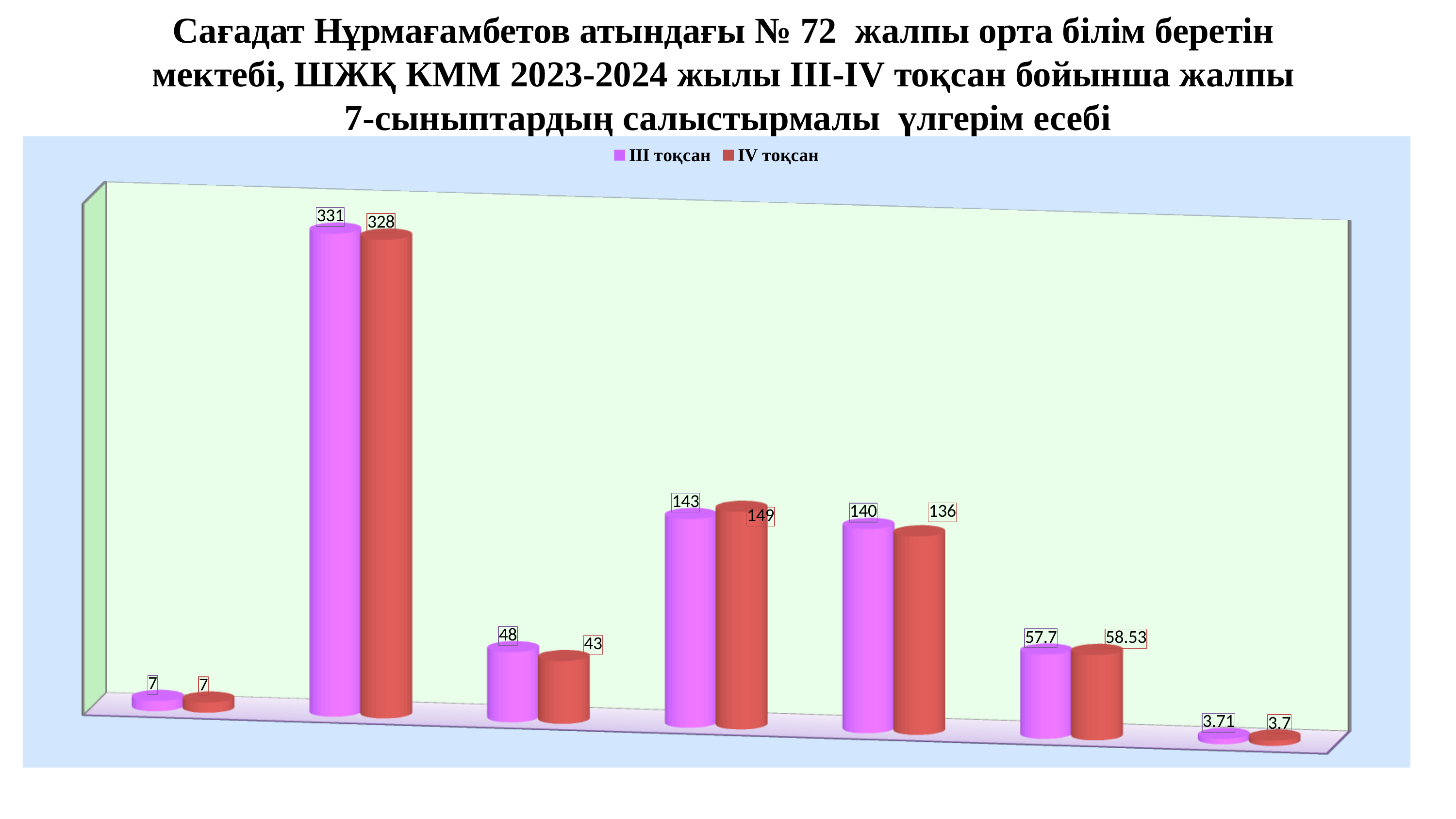
In the fifth group of bars from the left, which is larger: the III тоқсан value or the IV тоқсан value? III тоқсан (140) What is the III тоқсан value for the second group of bars from the left? 331 Which group of bars has the highest III тоқсан value? the second group from the left (331) Which series is shown in red in the legend? IV тоқсан How many groups of bars are plotted along the x axis? 7 What is the IV тоқсан value for the fourth group of bars from the left? 149 What is the difference between the III тоқсан and IV тоқсан values in the third group of bars from the left? 5 What is the III тоқсан value for the sixth group of bars from the left? 57.7 What is the IV тоқсан value for the last group of bars on the right? 3.7 What kind of chart is shown on the slide? bar chart What is the IV тоқсан value for the second group of bars from the left? 328 How many series does the legend list? 2